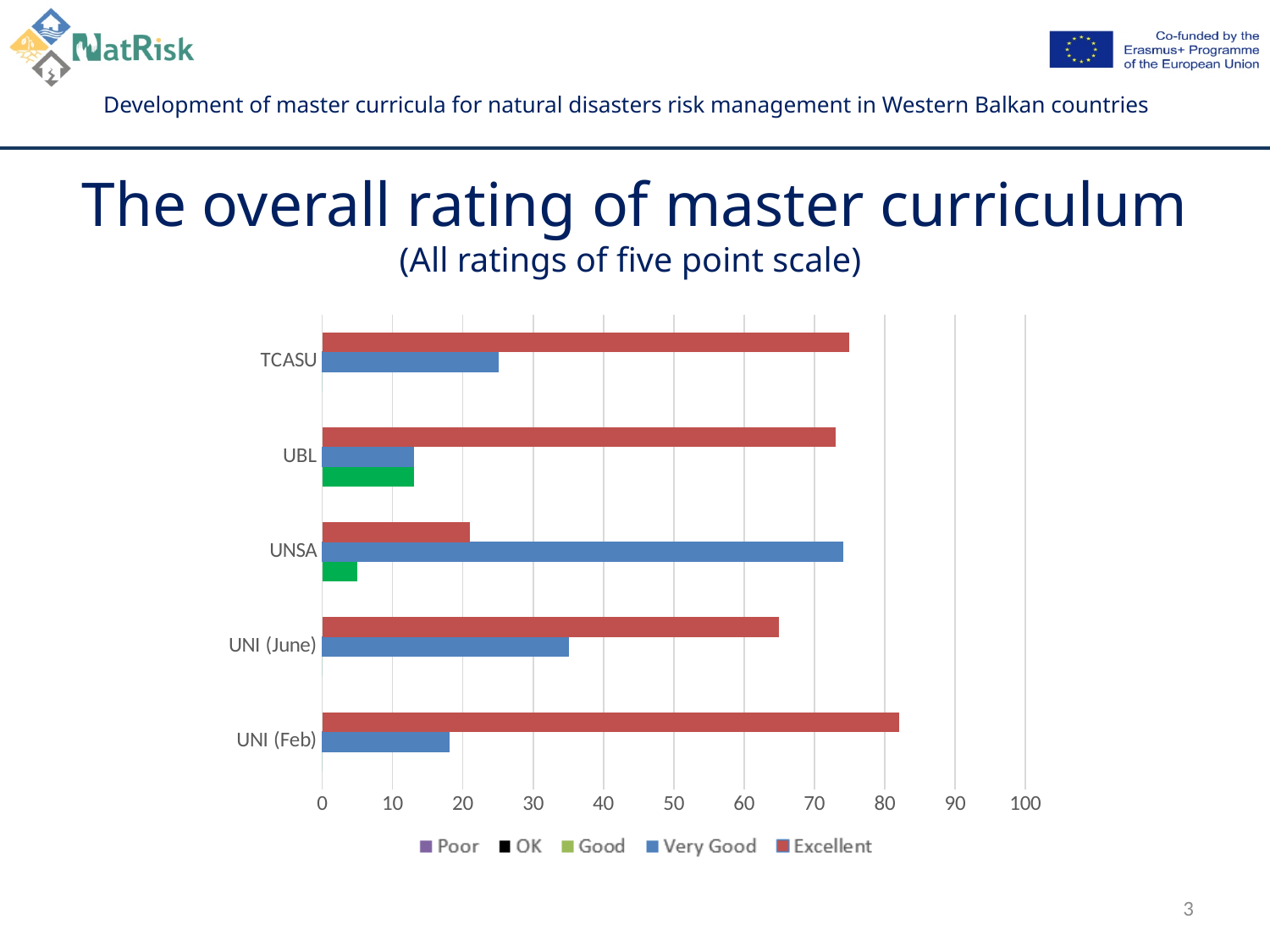
Is the Very Good value for UNI (June) greater or less than 30? greater Is the Very Good value for UBL greater or less than 20? less Which category has the highest Very Good value? UNSA For UNSA, which is larger: the Very Good value or the Excellent value? Very Good Is the Excellent value for TCASU greater or less than 70? greater Which category has the lowest Excellent value? UNSA Which is larger: the Excellent value for UNI (Feb) or for UNI (June)? UNI (Feb) Which category has the highest Excellent value? UNI (Feb) What kind of chart is shown on the slide? bar chart How many series does the legend list? 5 How many categories (institutions) are shown on the y axis? 5